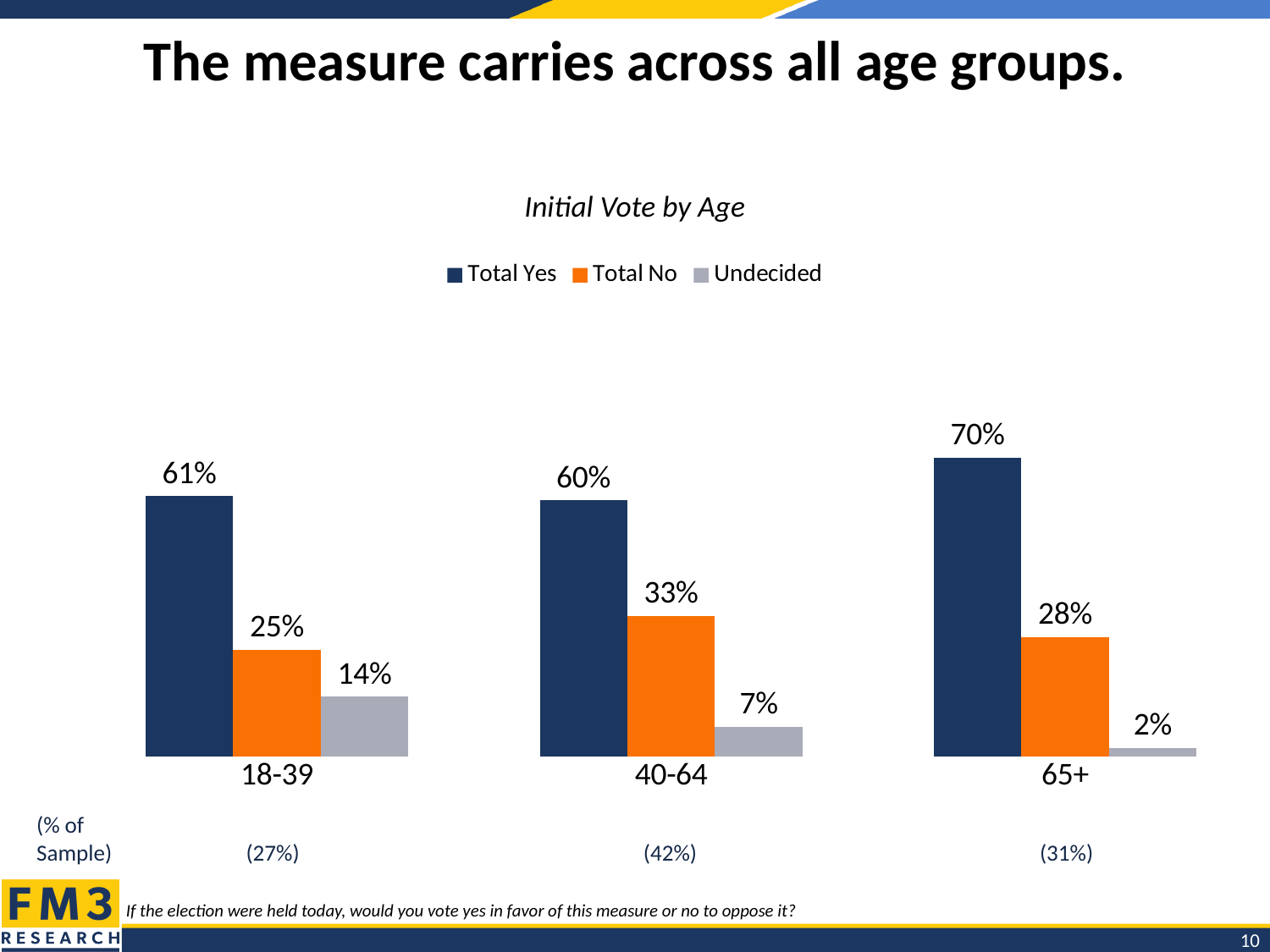
Which age group has the highest Total Yes value? 65+ What is the Total No value for the 40-64 age group? 33% How many series does the legend list? 3 How many age groups are shown on the x axis? 3 What is the difference between Total Yes and Total No for the 65+ age group? 42% Which is larger, the Total No value for 40-64 or the Total No value for 18-39? 40-64 What kind of chart is shown on the slide? Bar chart Which age group has the lowest Undecided value? 65+ What is the Total Yes value for the 18-39 age group? 61% What is the title of the chart? Initial Vote by Age Do the Undecided values rise or fall from the 18-39 group to the 65+ group? Fall What is the Undecided value for the 65+ age group? 2%